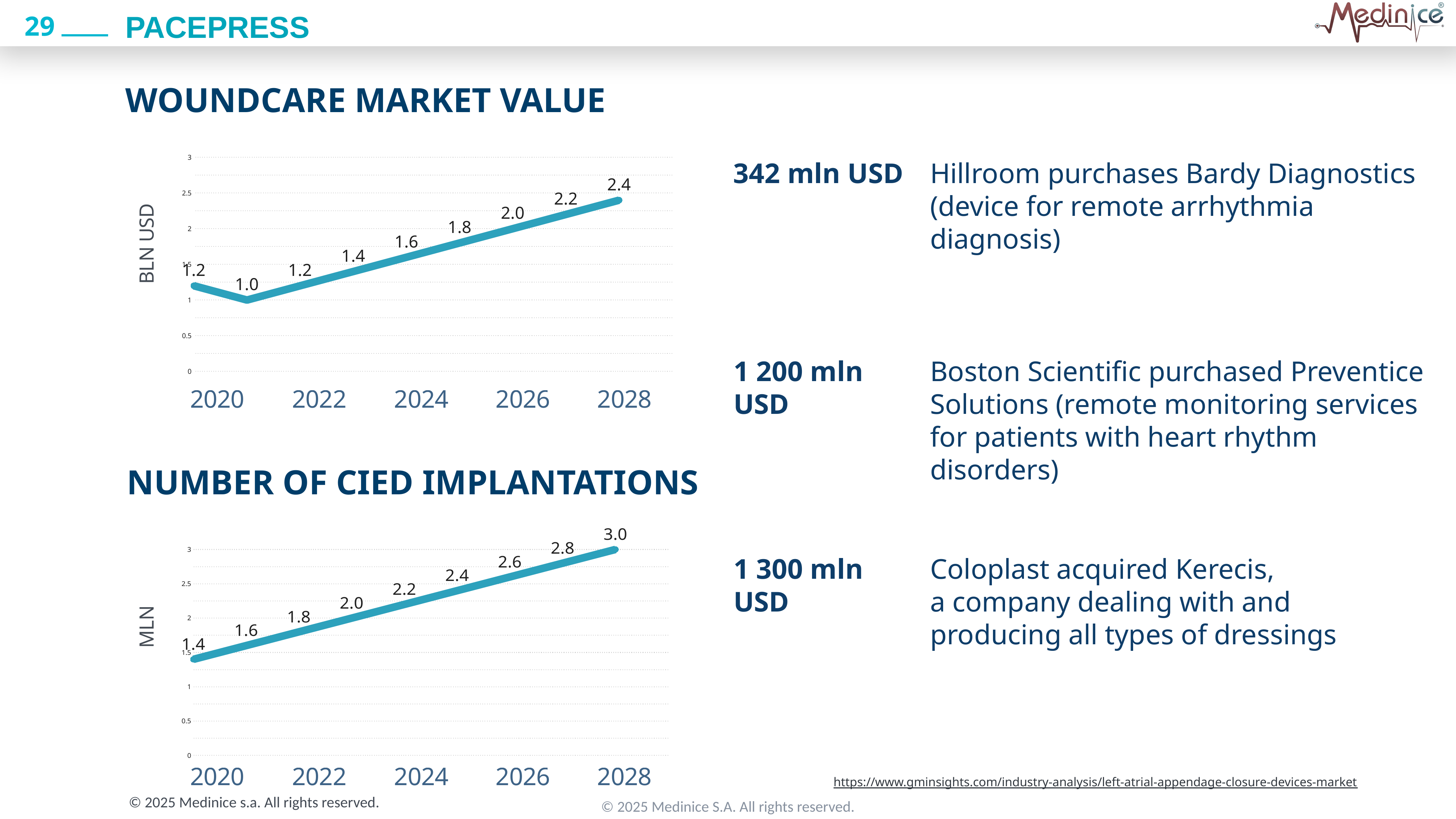
In the Woundcare Market Value chart, what unit is shown on the vertical axis? BLN USD In the Woundcare Market Value chart, what is the difference between the 2028 value and the 2020 value? 1.2 In the Woundcare Market Value chart, what is the value for 2020? 1.2 In the Number of CIED Implantations chart, do the values rise or fall from 2020 to 2028? Rise What type of chart is the Woundcare Market Value chart? Line chart How many data points are plotted in the Number of CIED Implantations chart? 9 In the Number of CIED Implantations chart, what is the value for 2024? 2.2 In the Woundcare Market Value chart, what is the value for 2028? 2.4 Which is larger: the 2026 value in the Number of CIED Implantations chart or the 2026 value in the Woundcare Market Value chart? Number of CIED Implantations (2.6) In the Woundcare Market Value chart, which year has the lowest value? 2021 In the Number of CIED Implantations chart, what is the value for 2020? 1.4 In the Number of CIED Implantations chart, which year has the highest value? 2028